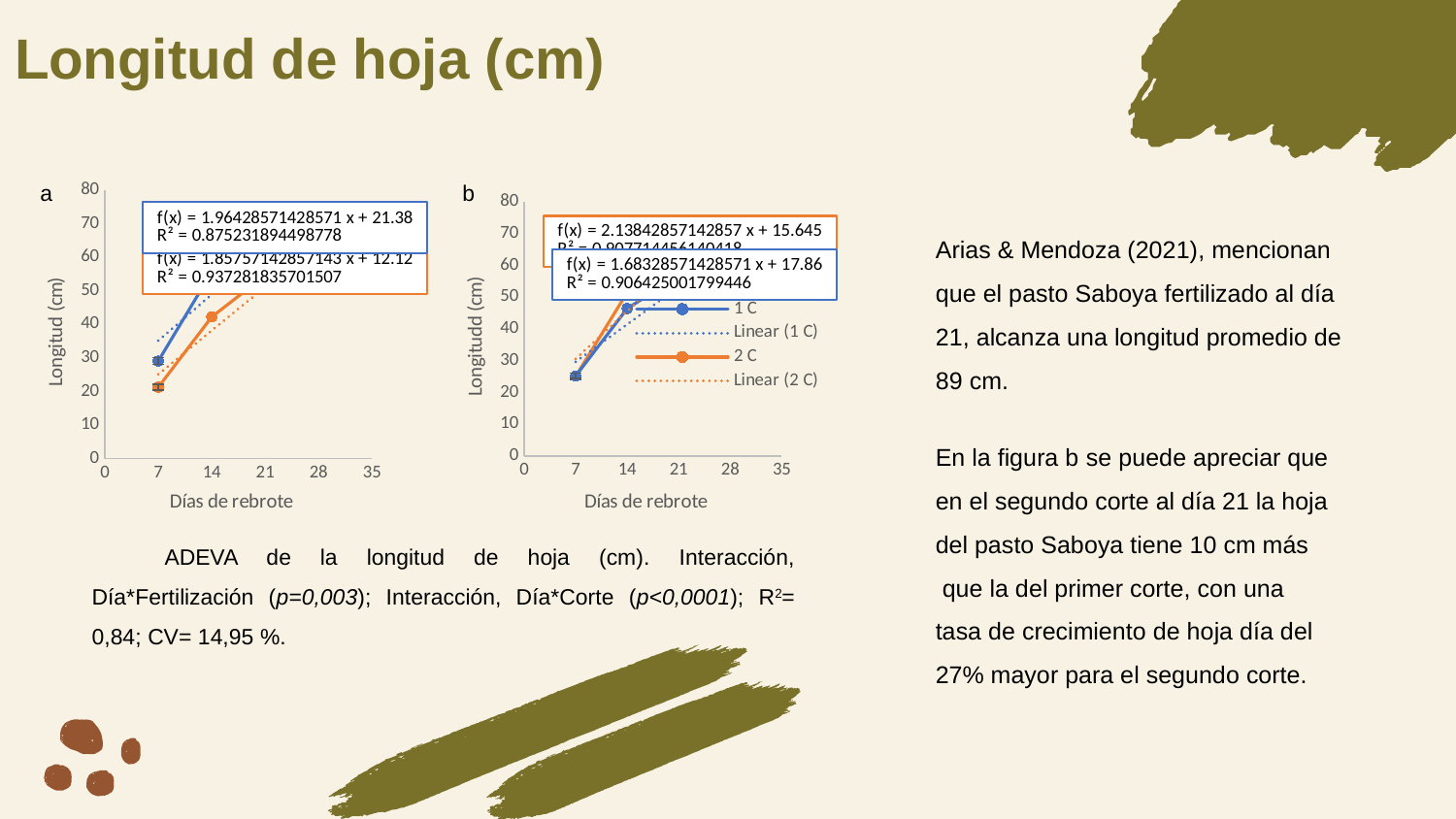
In chart b, is the value of series 1 C at day 7 greater or less than 40? less In chart a, is the blue series value at day 7 greater or less than 40? less In chart b, what R² value is shown for the trend line with equation f(x) = 1.68328571428571 x + 17.86? 0.906425001799446 How many entries does the legend of chart b list? 4 What are the legend entries of chart b? 1 C, Linear (1 C), 2 C, Linear (2 C) What kind of chart is chart a on the left? line chart In chart a, at day 7, which series has the larger value, the blue one or the orange one? the blue one In chart a, does the blue series rise or fall from day 7 to day 14? rises In chart a, what R² value is shown for the trend line with equation f(x) = 1.96428571428571 x + 21.38? 0.875231894498778 What is the y-axis title of chart a? Longitud (cm) In chart a, is the orange series value at day 7 greater or less than 30? less